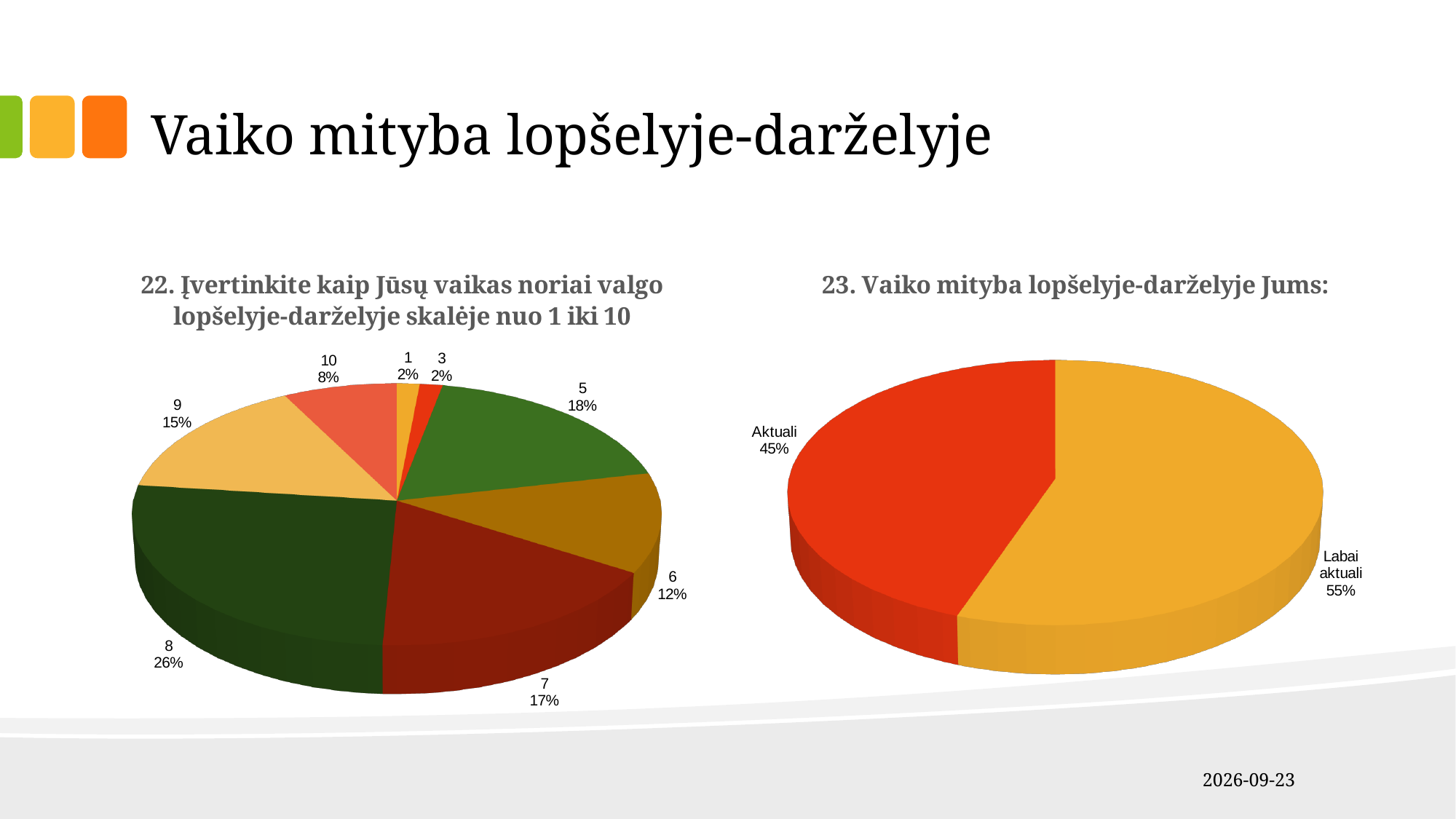
In the left chart (question 22), what percentage is shown for category 10? 8% In the left chart (question 22), which is larger, the slice for 9 or the slice for 6? 9 In the left chart (question 22), what share of the pie does category 8 have? 26% In the left chart (question 22), which category has the largest slice? 8 What is the title of the chart on the right side of the slide? 23. Vaiko mityba lopšelyje-darželyje Jums: In the right chart (question 23), which slice is larger, 'Aktuali' or 'Labai aktuali'? Labai aktuali What type of chart is used for question 23 on the right side of the slide? Pie chart In the right chart (question 23), what share is labelled 'Labai aktuali'? 55% In the left chart (question 22), how many slices does the pie have? 8 In the left chart (question 22), what is the difference in percentage points between category 8 and category 7? 9 In the right chart (question 23), what percentage is shown for 'Aktuali'? 45% In the left chart (question 22), what percentage is shown for category 5? 18%